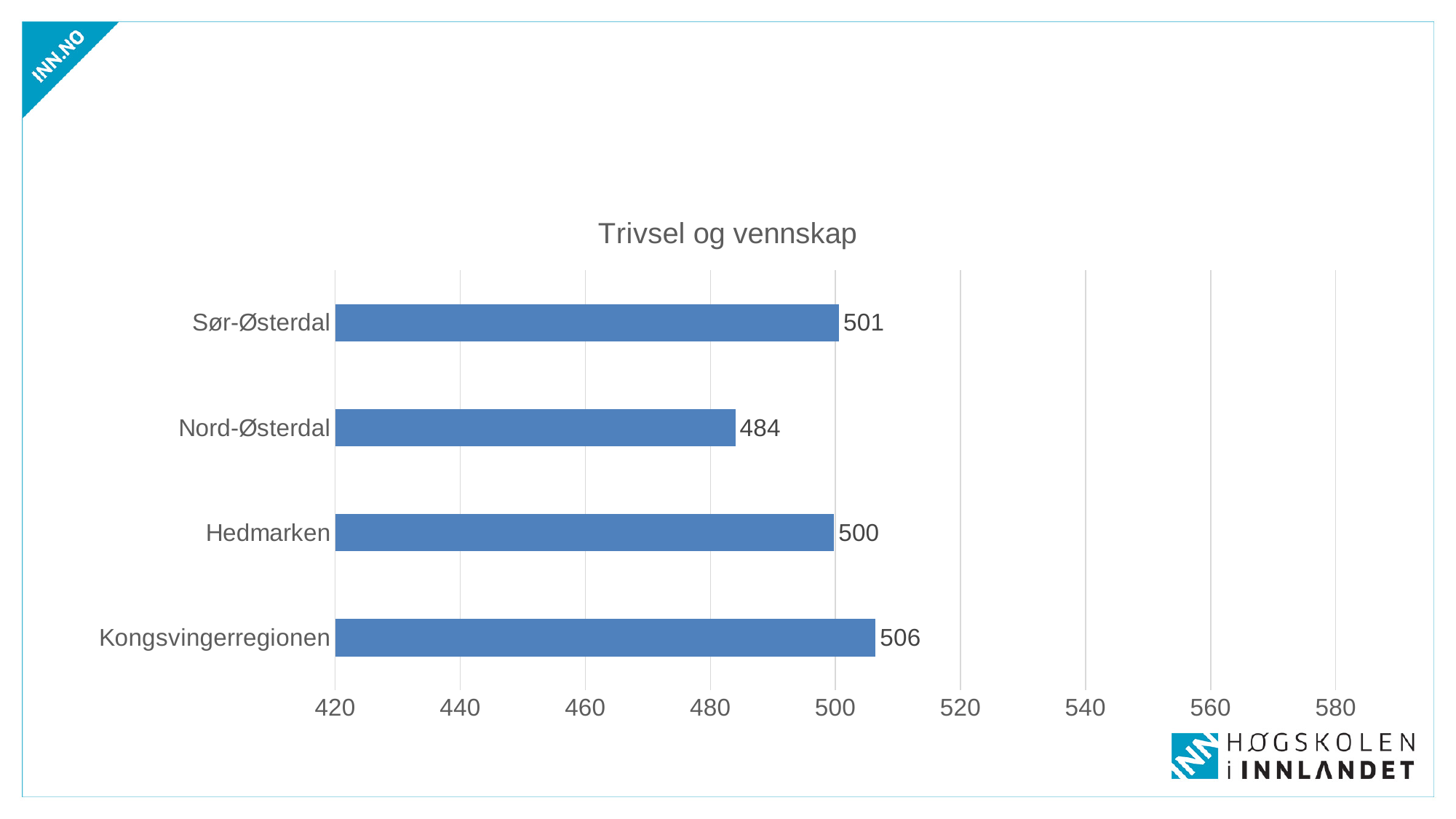
Which is larger, the value for Sør-Østerdal or the value for Nord-Østerdal? Sør-Østerdal What is the value for Sør-Østerdal? 501 What is the value for Hedmarken? 500 What is the value for Kongsvingerregionen? 506 What kind of chart is shown on the slide? Bar chart What is the difference between the values for Sør-Østerdal and Hedmarken? 1 What is the value for Nord-Østerdal? 484 Which category has the highest value? Kongsvingerregionen What is the difference between the values for Kongsvingerregionen and Nord-Østerdal? 22 What is the title of the chart? Trivsel og vennskap How many categories are shown in the chart? 4 Which category has the lowest value? Nord-Østerdal